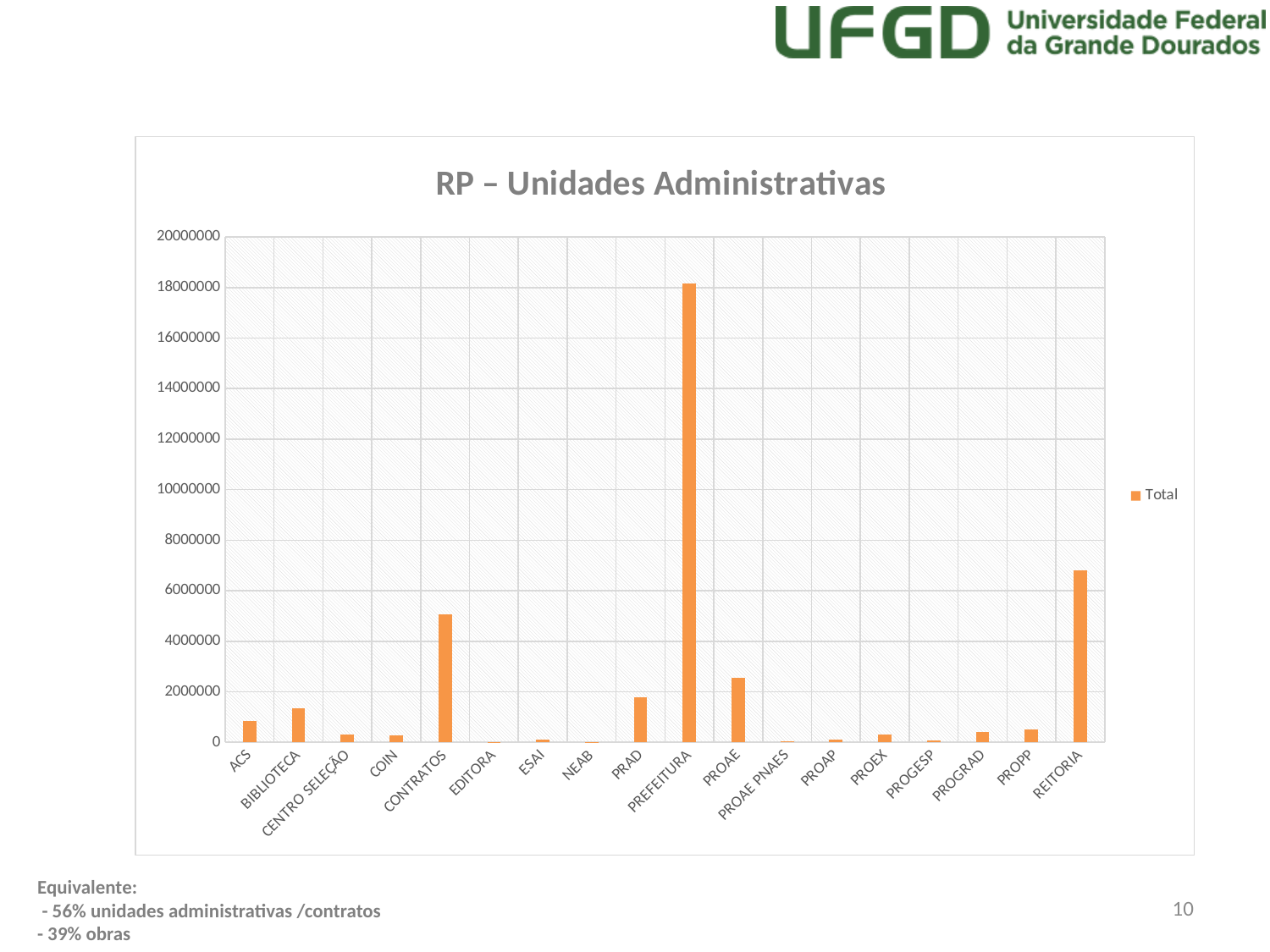
Is the value for PREFEITURA greater or less than 16000000? greater Is the value for REITORIA greater or less than 8000000? less How many categories are shown on the x axis? 18 Which is larger, the value for PROAE or the value for PRAD? PROAE Is the value for CONTRATOS greater or less than 4000000? greater What is the title of the chart? RP – Unidades Administrativas How many series does the legend list? 1 Which category has the highest value? PREFEITURA What is the name of the series shown in the legend? Total What kind of chart is shown on the slide? bar chart Which is larger, the value for REITORIA or the value for CONTRATOS? REITORIA